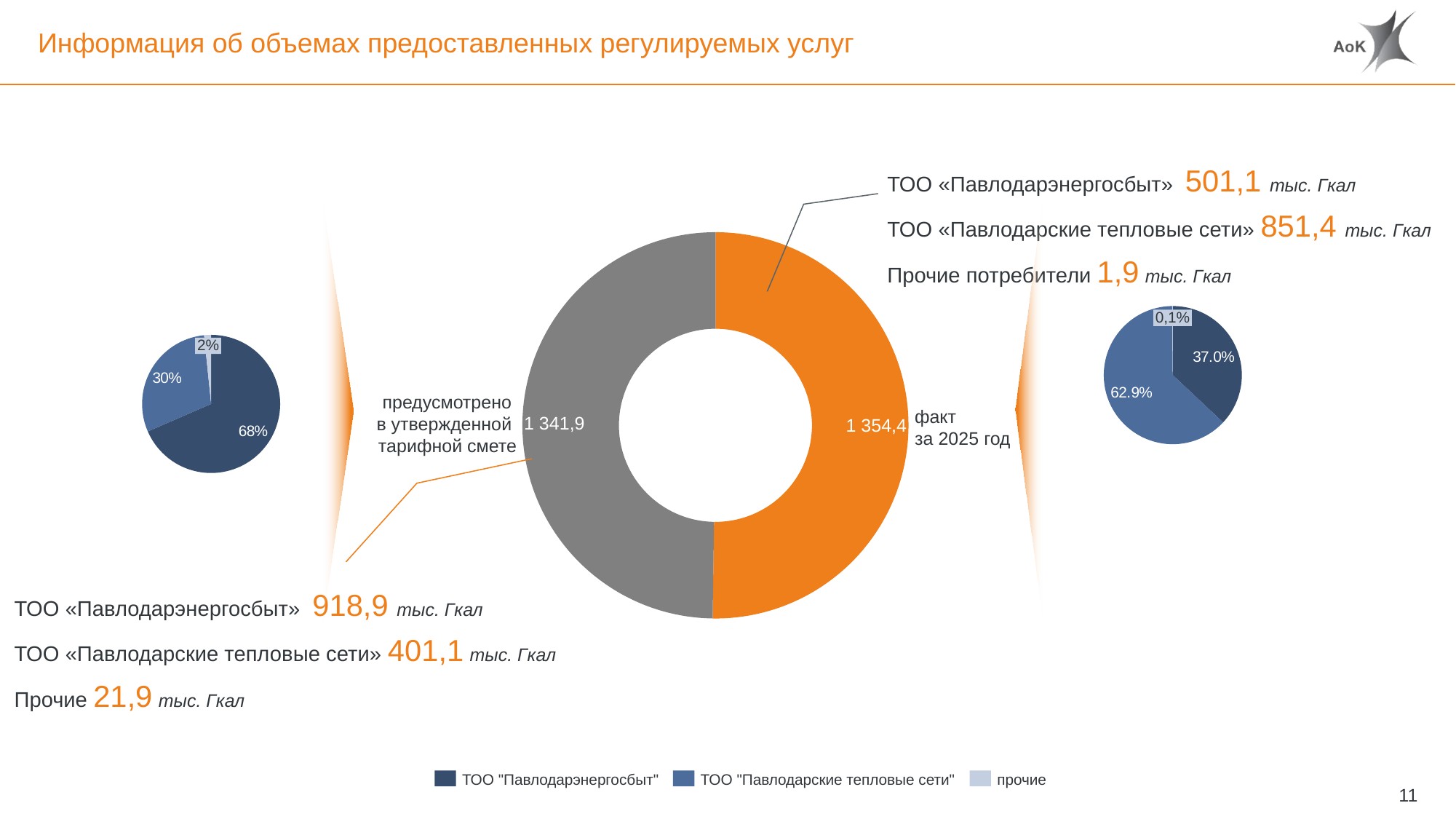
In the right pie chart, which category has the largest slice? ТОО "Павлодарские тепловые сети" In the central donut chart, which is larger: факт за 2025 год or предусмотрено в утвержденной тарифной смете? факт за 2025 год In the left pie chart, what share is shown for ТОО "Павлодарэнергосбыт" (the dark navy slice)? 68% In the left pie chart, which category has the largest slice? ТОО "Павлодарэнергосбыт" In the central donut chart, what is the difference between факт за 2025 год and предусмотрено в утвержденной тарифной смете? 12,5 How many entries does the legend at the bottom of the slide list? 3 In the central donut chart, what value is shown for предусмотрено в утвержденной тарифной смете? 1 341,9 In the central donut chart, what value is shown for факт за 2025 год? 1 354,4 In the left pie chart, which category has the smallest slice? прочие In the right pie chart, what share is shown for прочие? 0.1% In the left pie chart, what is the difference in percentage points between the ТОО "Павлодарэнергосбыт" slice and the ТОО "Павлодарские тепловые сети" slice? 38 percentage points In the right pie chart, what share is shown for ТОО "Павлодарские тепловые сети"? 62.9%